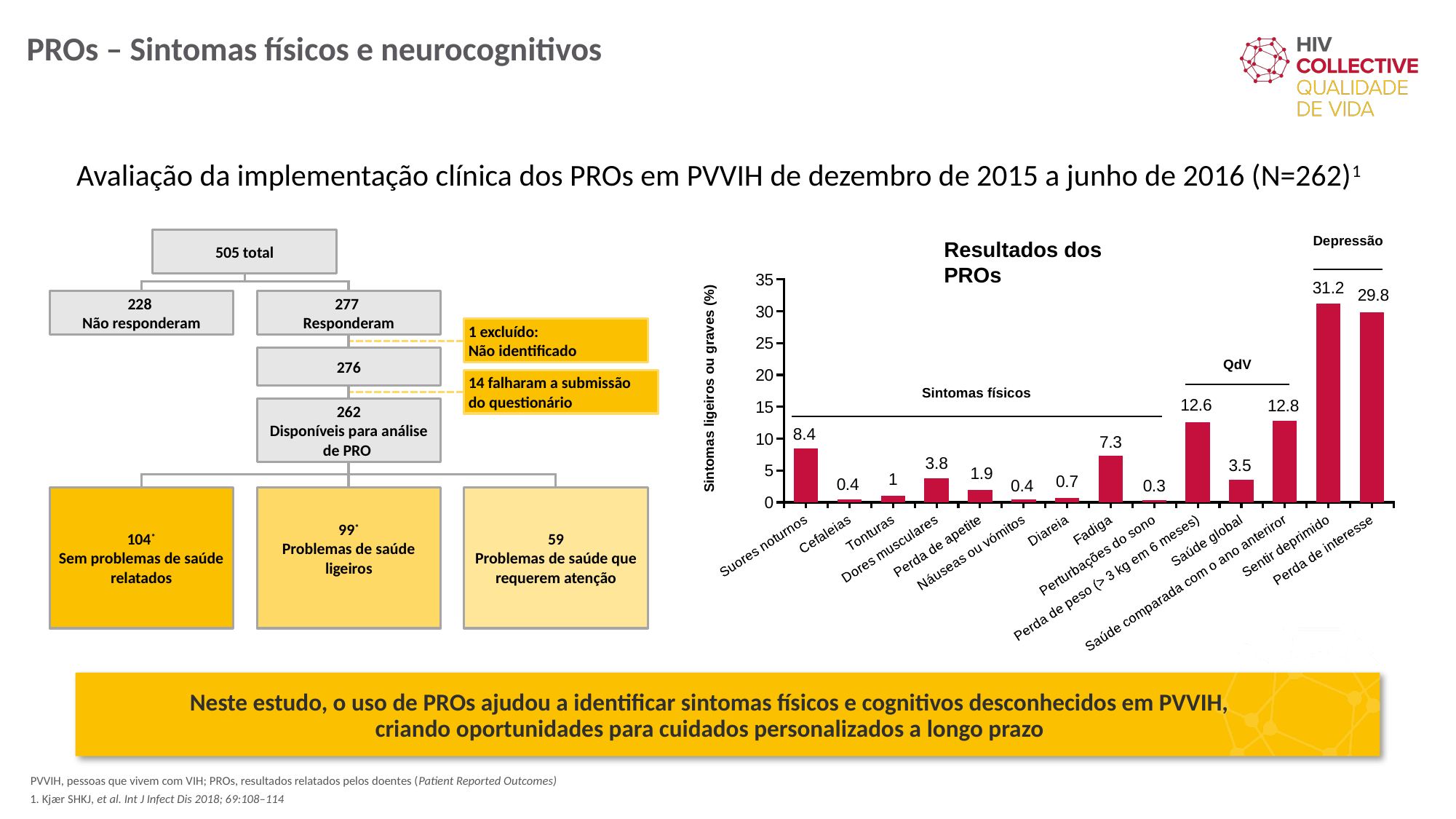
Which category has the highest value in the Resultados dos PROs chart? Sentir deprimido What is the value for Fadiga in the Resultados dos PROs chart? 7.3 What type of chart is the Resultados dos PROs chart? Bar chart What is the difference between Perda de peso (> 3 kg em 6 meses) and Saúde global in the Resultados dos PROs chart? 9.1 What is the value for Suores noturnos in the Resultados dos PROs chart? 8.4 What is the y-axis label of the Resultados dos PROs chart? Sintomas ligeiros ou graves (%) Which is larger in the Resultados dos PROs chart: Dores musculares or Saúde global? Dores musculares What is the value for Sentir deprimido in the Resultados dos PROs chart? 31.2 Which category has the lowest value in the Resultados dos PROs chart? Perturbações do sono What is the value for Saúde comparada com o ano anterior in the Resultados dos PROs chart? 12.8 How many categories are shown in the Resultados dos PROs chart? 14 What is the difference between Sentir deprimido and Perda de interesse in the Resultados dos PROs chart? 1.4